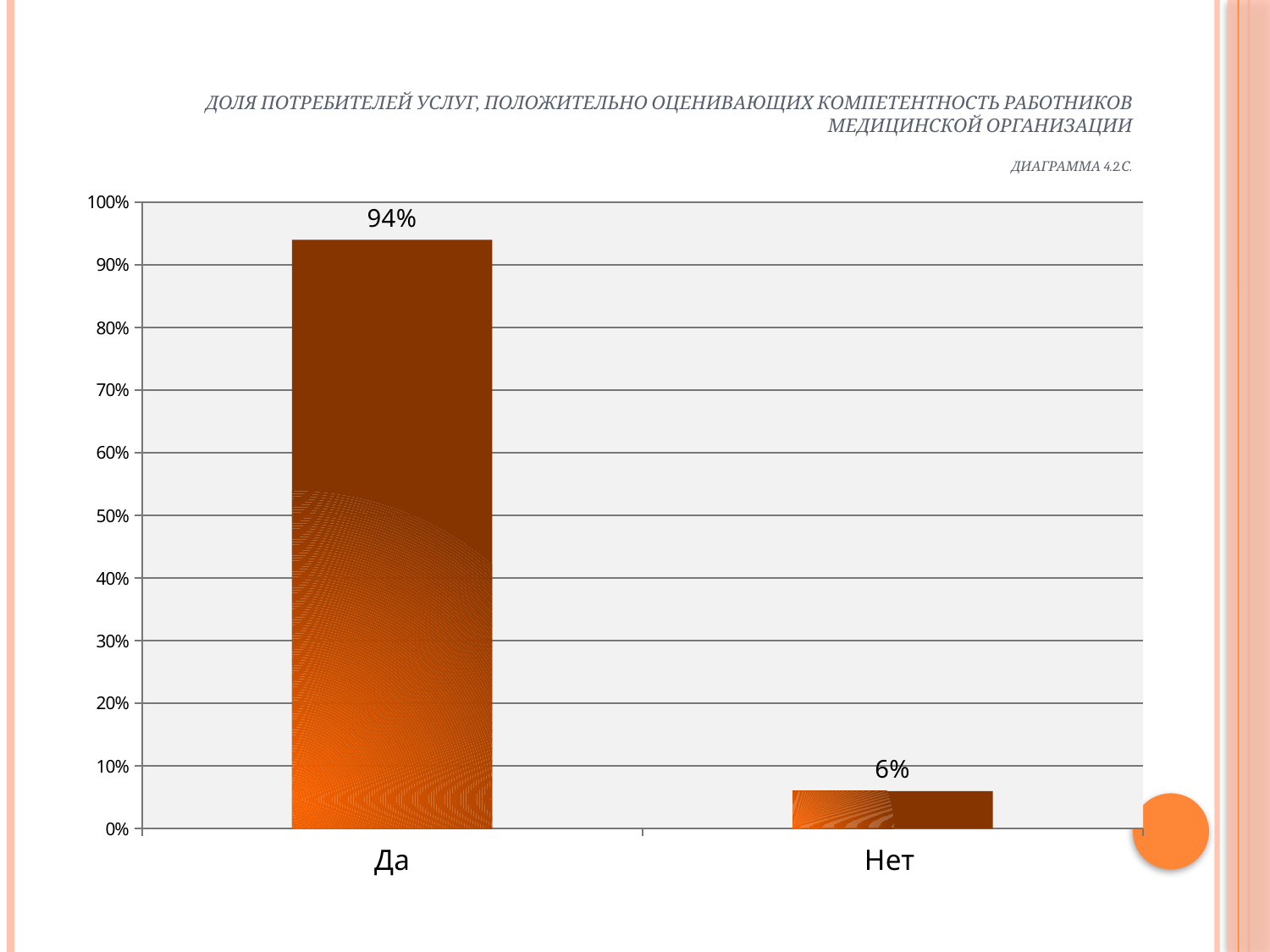
Which is larger, the value for Да or the value for Нет? Да What is the value for Да? 94% How many categories are shown on the x axis? 2 What is the difference between the values for Да and Нет? 88% What is the value for Нет? 6% What kind of chart is shown on the slide? bar chart Is the value for Да greater or less than 90%? greater Which category has the lowest value? Нет Which category has the highest value? Да What is the total of the two values shown? 100% What is the diagram number given under the chart title? Диаграмма 4.2С. Is the value for Нет greater or less than 10%? less